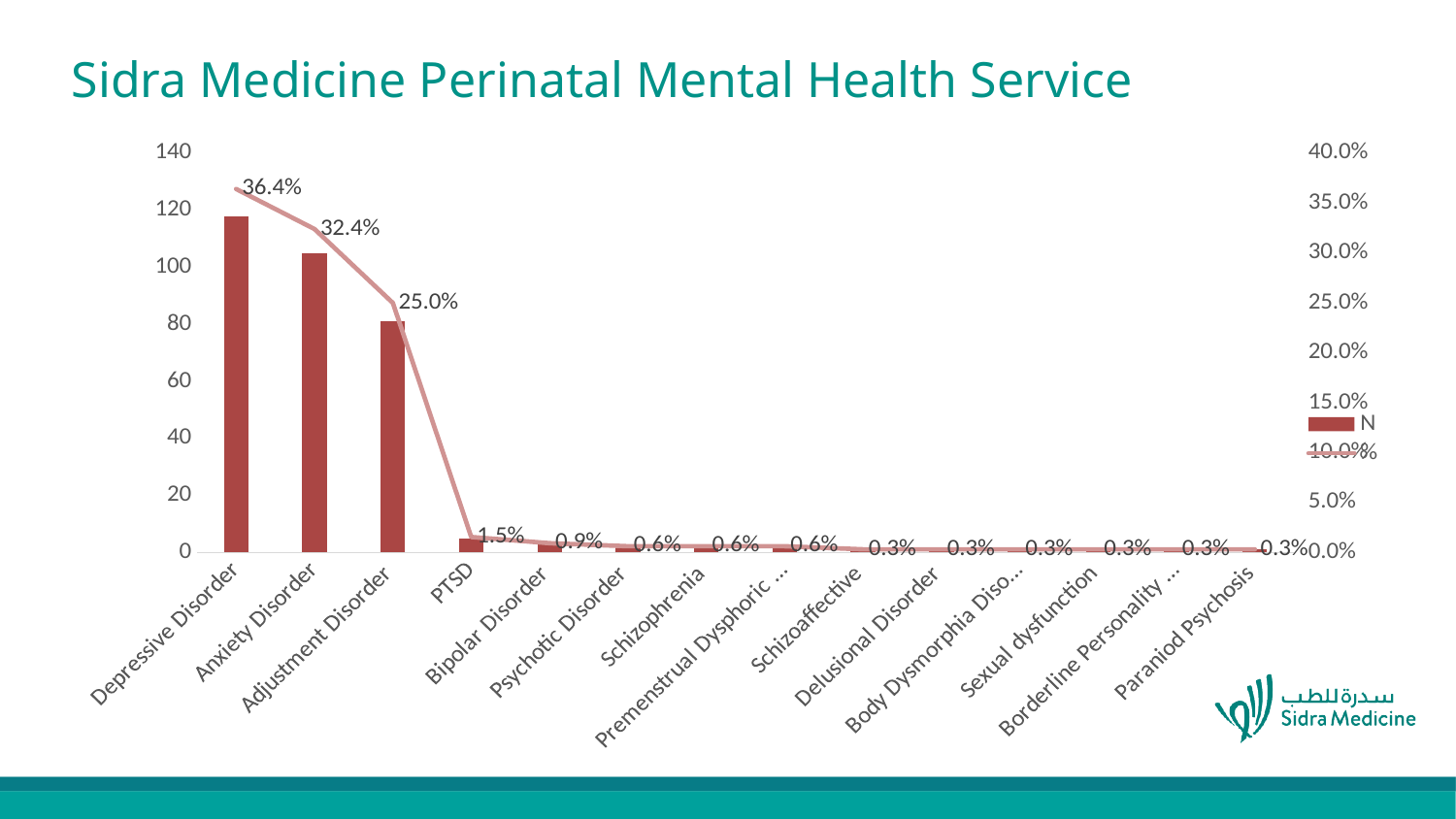
What percentage is shown for Adjustment Disorder? 25.0% What percentage is shown for Bipolar Disorder? 0.9% Which has a higher percentage, Adjustment Disorder or PTSD? Adjustment Disorder What percentage is shown for PTSD? 1.5% Is the N bar for Adjustment Disorder greater or less than 100? less What percentage is shown for Depressive Disorder? 36.4% Which diagnosis has the highest percentage? Depressive Disorder Is the N bar for Depressive Disorder greater or less than 100? greater What is the difference in percentage between Depressive Disorder and Anxiety Disorder? 4.0% What is the difference in percentage between Anxiety Disorder and Adjustment Disorder? 7.4% How many diagnosis categories are shown on the x axis? 14 What percentage is shown for Anxiety Disorder? 32.4%